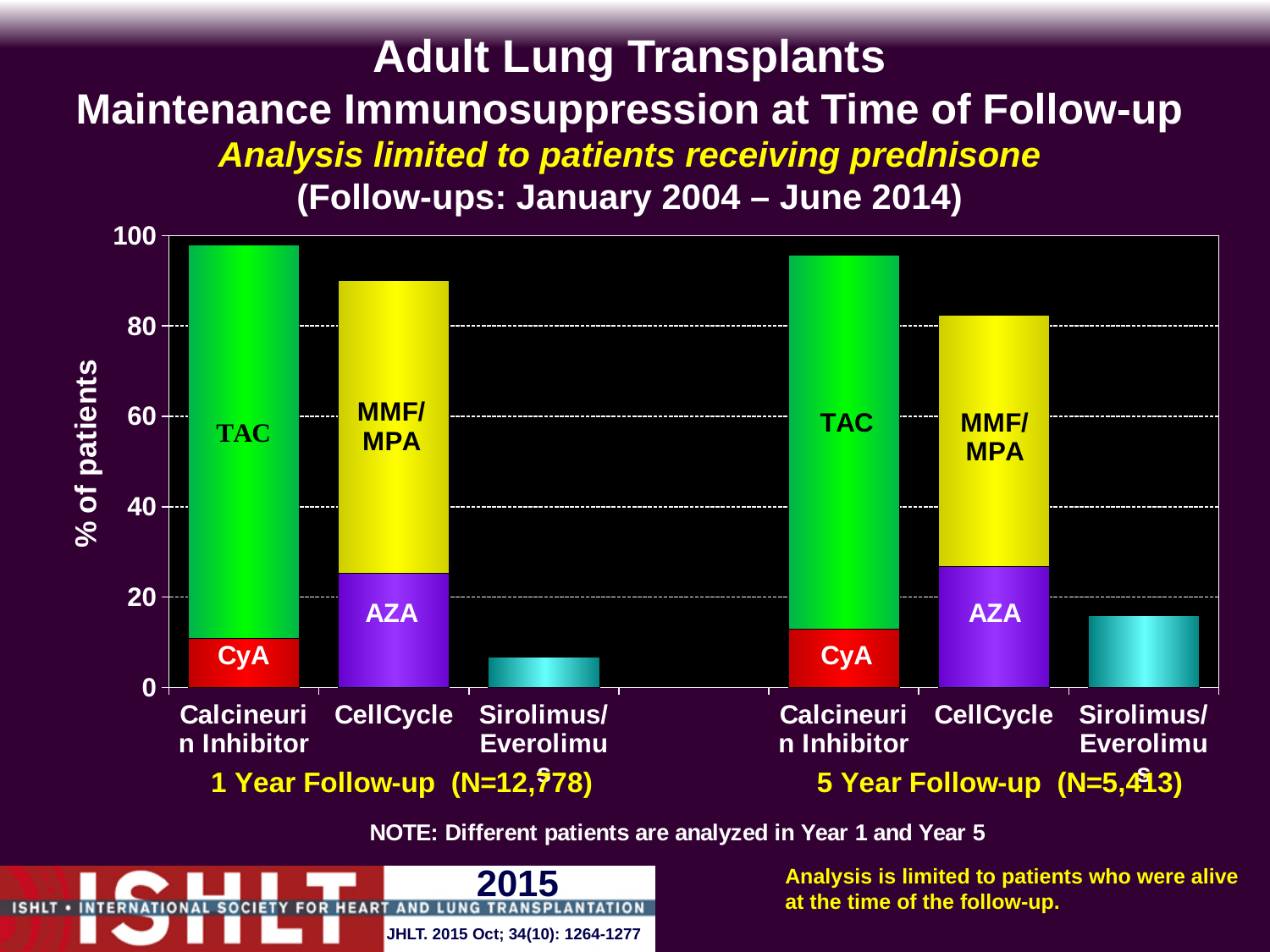
What is the N shown for the 1 Year Follow-up group? N=12,778 What kind of chart is shown on the slide? Stacked bar chart In the 1 Year Follow-up group, is the total value for Calcineurin Inhibitor greater or less than 80? greater Which is larger: the Sirolimus/Everolimus value at 1 Year Follow-up or at 5 Year Follow-up? 5 Year Follow-up Which category has the tallest bar in the 1 Year Follow-up group? Calcineurin Inhibitor In the 5 Year Follow-up group, is the total value for CellCycle greater or less than 60? greater In the 1 Year Follow-up group, is the value for Sirolimus/Everolimus greater or less than 20? less How many drug categories are shown on the x axis for the 1 Year Follow-up group? 3 What is the label of the y axis? % of patients Which category has the shortest bar in the 5 Year Follow-up group? Sirolimus/Everolimus